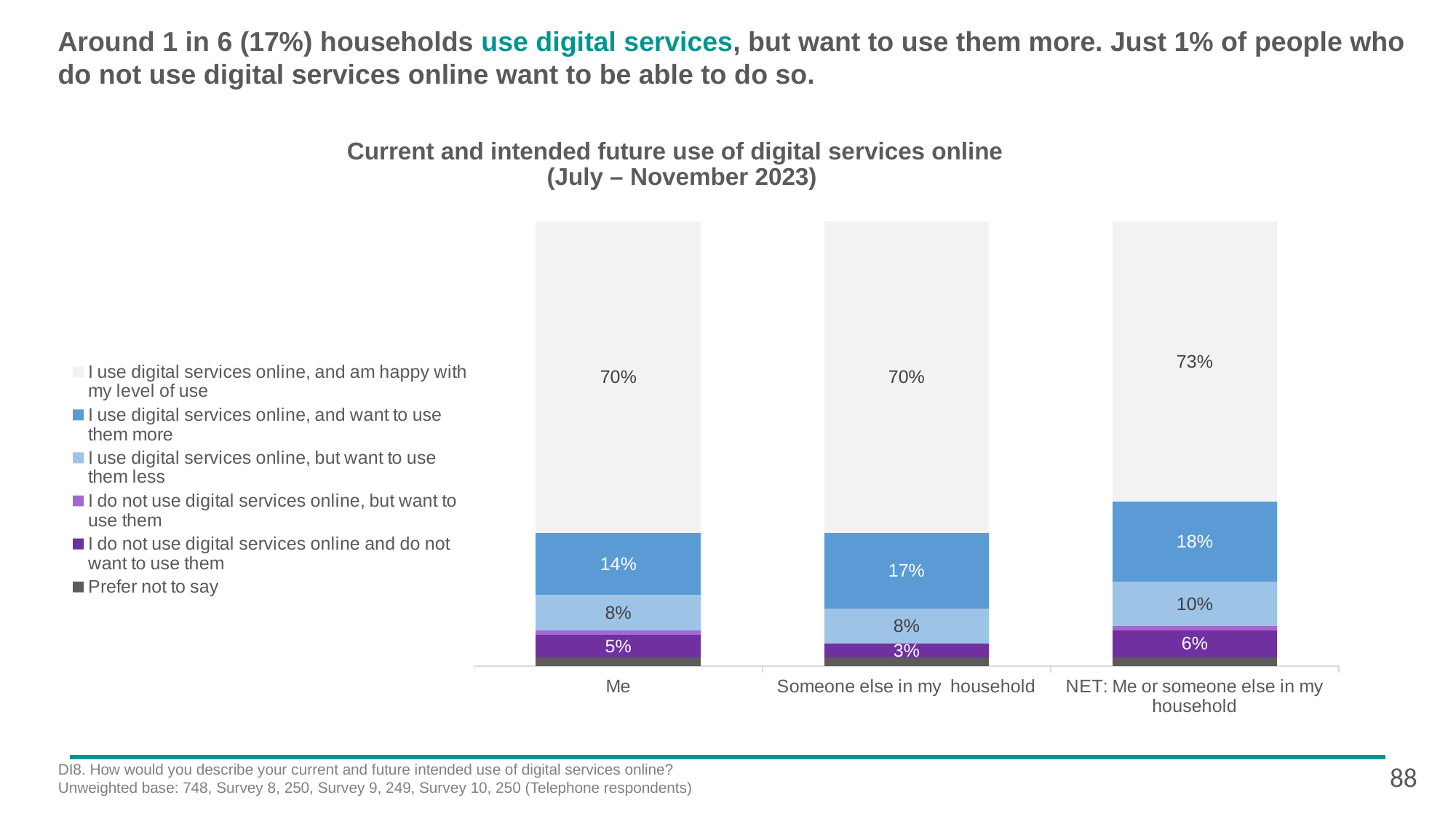
What percentage of the 'NET: Me or someone else in my household' bar is 'I use digital services online, and am happy with my level of use'? 73% What is the difference between the 'I use digital services online, and want to use them more' values for 'NET: Me or someone else in my household' and 'Me'? 4% What percentage of the 'Me' bar is 'I do not use digital services online and do not want to use them'? 5% Which category has the lowest value for 'I do not use digital services online and do not want to use them'? Someone else in my household Which is larger: the 'I do not use digital services online and do not want to use them' value for 'Me' or for 'Someone else in my household'? Me What kind of chart is shown on the slide? Stacked bar chart What percentage of the 'NET: Me or someone else in my household' bar is 'I use digital services online, but want to use them less'? 10% Which category has the highest value for 'I use digital services online, and want to use them more'? NET: Me or someone else in my household What percentage of the 'Someone else in my household' bar is 'I use digital services online, and want to use them more'? 17% How many series does the chart's legend list? 6 What percentage of the 'Me' bar is 'I use digital services online, and am happy with my level of use'? 70% How many categories are shown along the x axis of the chart? 3